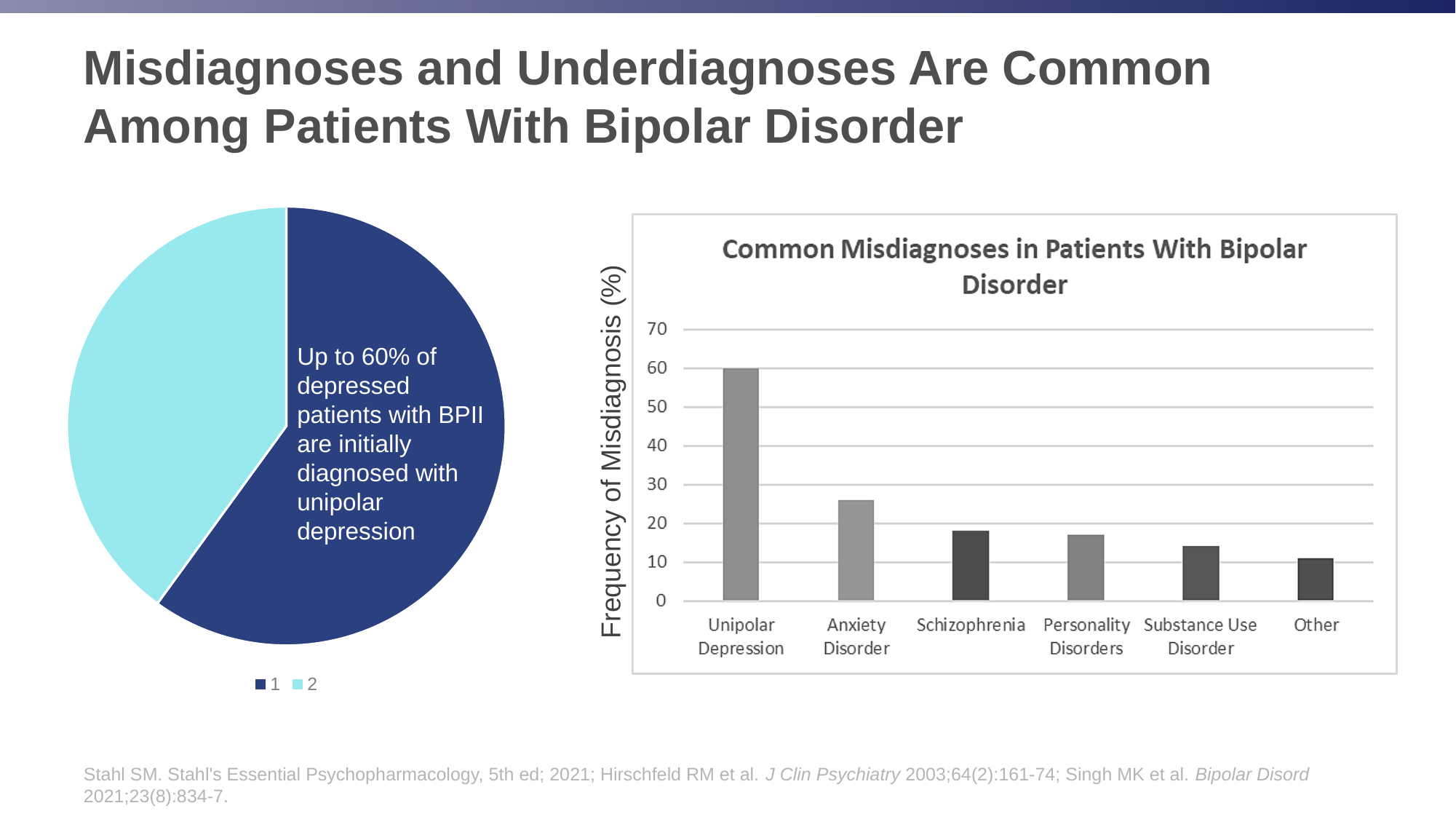
In the 'Common Misdiagnoses in Patients With Bipolar Disorder' chart, do the values generally rise or fall moving from left to right along the x axis? fall How many entries does the legend of the pie chart on the left list? 2 In the 'Common Misdiagnoses in Patients With Bipolar Disorder' chart, is the value for Anxiety Disorder greater or less than 20? greater In the 'Common Misdiagnoses in Patients With Bipolar Disorder' chart, which category has the highest frequency of misdiagnosis? Unipolar Depression In the 'Common Misdiagnoses in Patients With Bipolar Disorder' chart, which is larger, the value for Unipolar Depression or the value for Anxiety Disorder? Unipolar Depression How many categories are shown on the x axis of the 'Common Misdiagnoses in Patients With Bipolar Disorder' chart? 6 In the 'Common Misdiagnoses in Patients With Bipolar Disorder' chart, is the value for Schizophrenia greater or less than 20? less What type of chart is the chart on the left of the slide? pie chart In the 'Common Misdiagnoses in Patients With Bipolar Disorder' chart, which category has the lowest frequency of misdiagnosis? Other What is the y-axis label of the 'Common Misdiagnoses in Patients With Bipolar Disorder' chart? Frequency of Misdiagnosis (%) What type of chart is the chart on the right titled 'Common Misdiagnoses in Patients With Bipolar Disorder'? bar chart